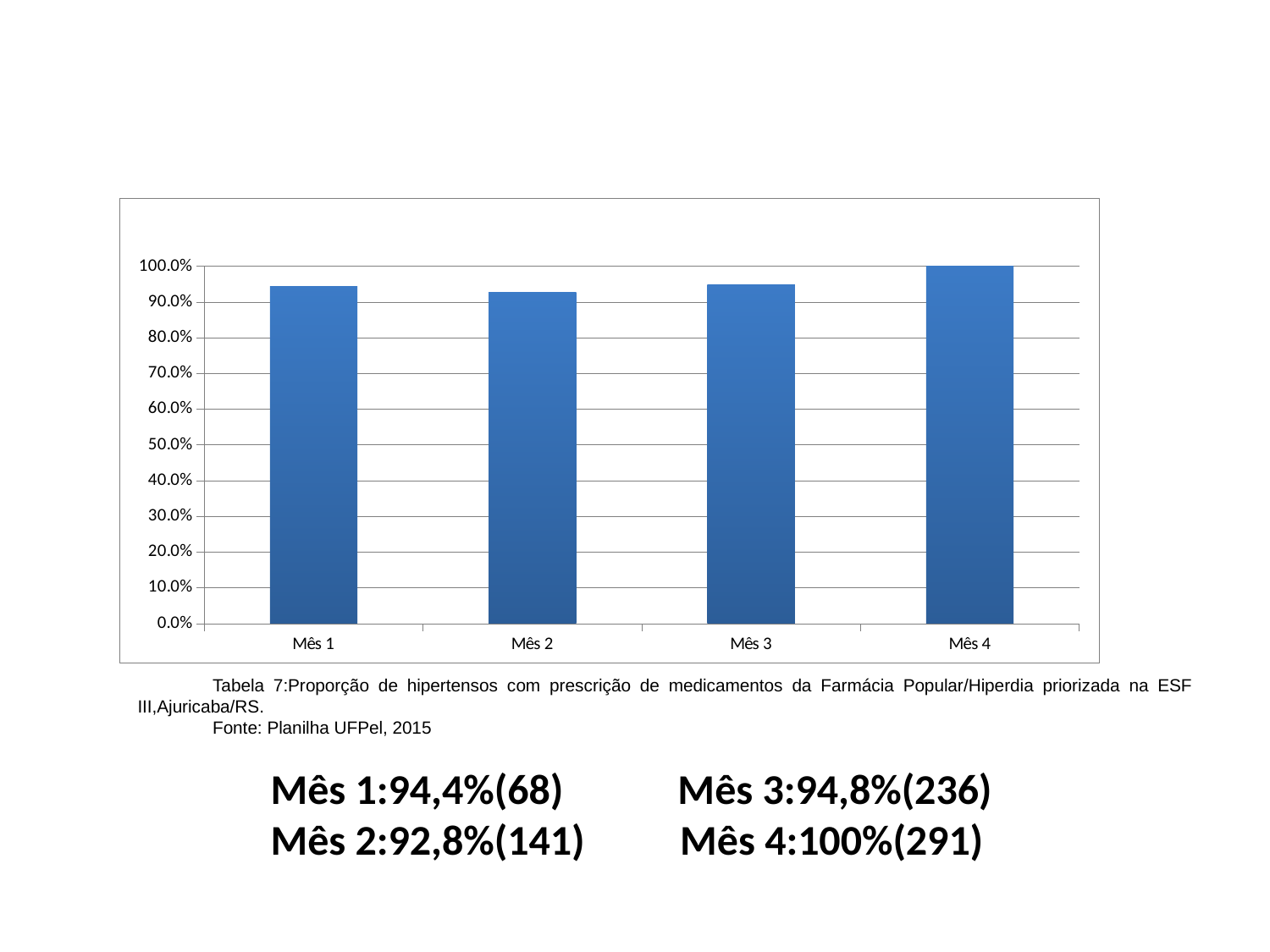
What is the value for Mês 1? 94,4% What kind of chart is shown on the slide? bar chart Which month has the lowest value? Mês 2 What is the difference between the values for Mês 4 and Mês 1? 5,6% Which is larger, the value for Mês 4 or the value for Mês 2? Mês 4 Is the value for Mês 2 greater or less than 90.0%? greater What source is cited below the chart? Planilha UFPel, 2015 What is the value for Mês 4? 100% What is the value for Mês 2? 92,8% Which month has the highest value? Mês 4 What is the difference between the values for Mês 4 and Mês 2? 7,2% How many months are shown on the x axis? 4